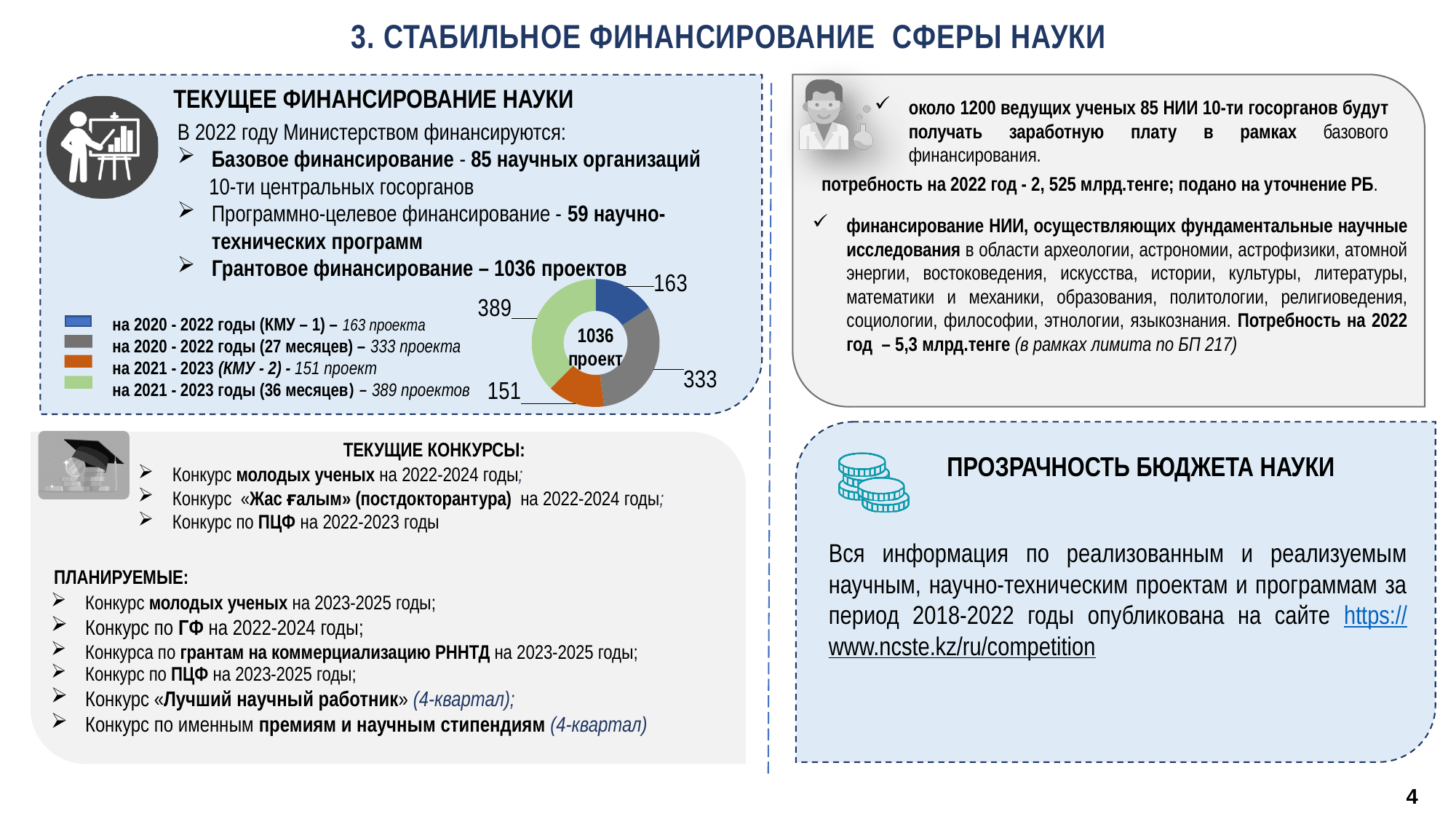
In the doughnut chart, what is the value for "на 2021 - 2023 (КМУ - 2)"? 151 In the doughnut chart, what is the value for "на 2020 - 2022 годы (27 месяцев)"? 333 Which category has the largest slice in the doughnut chart? на 2021 - 2023 годы (36 месяцев) What is the difference between the 389 slice and the 333 slice in the doughnut chart? 56 Which category has the smallest slice in the doughnut chart? на 2021 - 2023 (КМУ - 2) In the doughnut chart, how many projects are shown for "на 2020 - 2022 годы (КМУ – 1)"? 163 In the doughnut chart, how many projects are shown for "на 2021 - 2023 годы (36 месяцев)"? 389 How many slices does the doughnut chart have? 4 Which is larger in the doughnut chart: "на 2020 - 2022 годы (27 месяцев)" or "на 2020 - 2022 годы (КМУ – 1)"? на 2020 - 2022 годы (27 месяцев) What total number of projects is shown in the centre of the doughnut chart? 1036 проект What type of chart is used to show the grant-funded projects? Doughnut (pie) chart By how many projects does "на 2020 - 2022 годы (КМУ – 1)" exceed "на 2021 - 2023 (КМУ - 2)" in the doughnut chart? 12